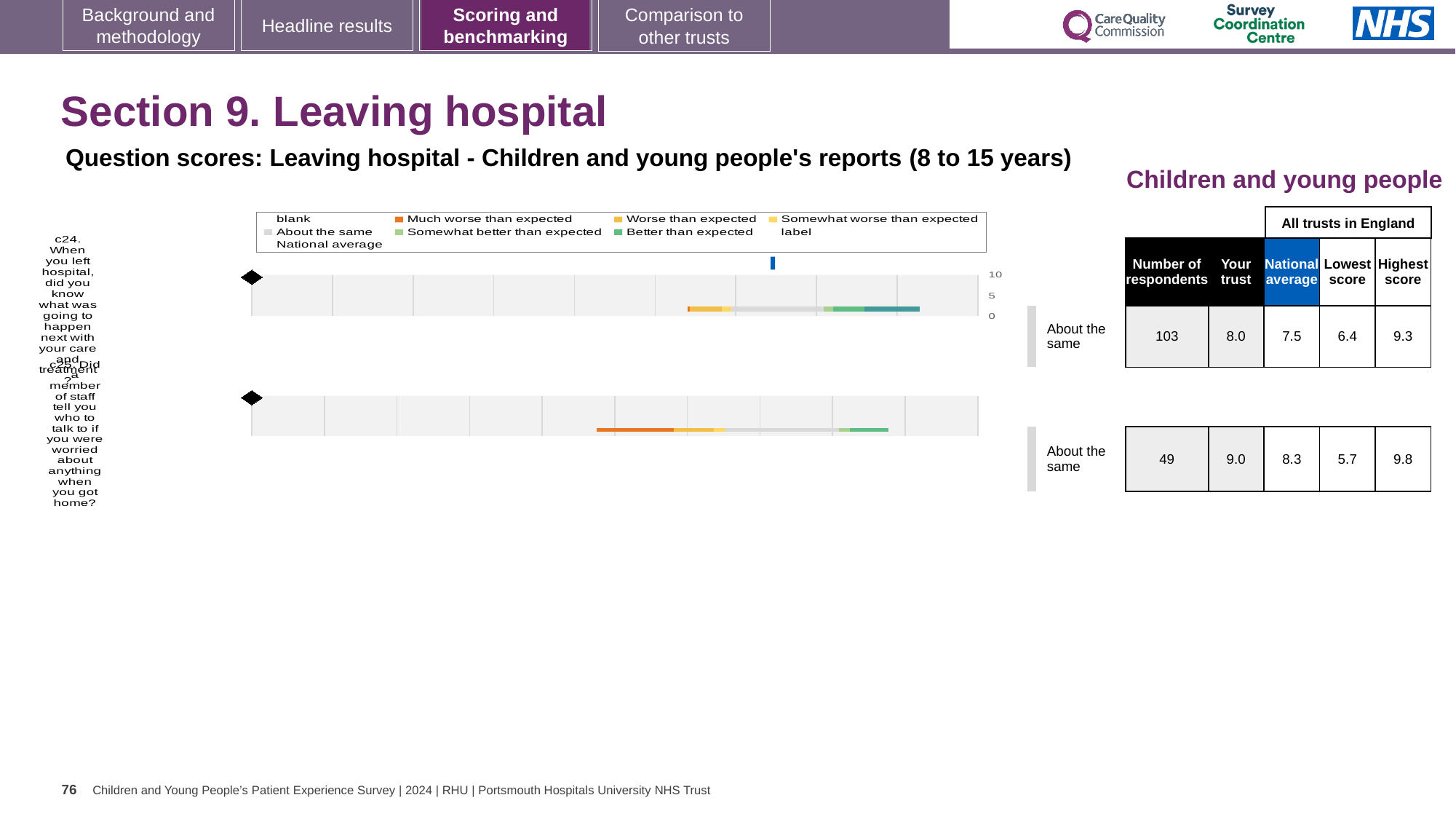
What benchmark category is shown for question c24? About the same How many respondents answered question c24? 103 What is the 'Your trust' score for question c24 (When you left hospital, did you know what was going to happen next with your care and treatment?)? 8.0 What is the highest score across all trusts in England for question c25? 9.8 Which question has the higher 'Your trust' score, c24 or c25? c25 How many questions are plotted in the Leaving hospital chart? 2 What colour does the legend use for 'Much worse than expected'? Orange Which question has the higher national average, c24 or c25? c25 What is the national average score for question c25 (Did a member of staff tell you who to talk to if you were worried about anything when you got home?)? 8.3 What kind of chart is used to show the question scores for c24 and c25? Bar chart What is the difference between the highest score and the lowest score for question c24? 2.9 By how much does the trust's score for c25 exceed the national average for c25? 0.7